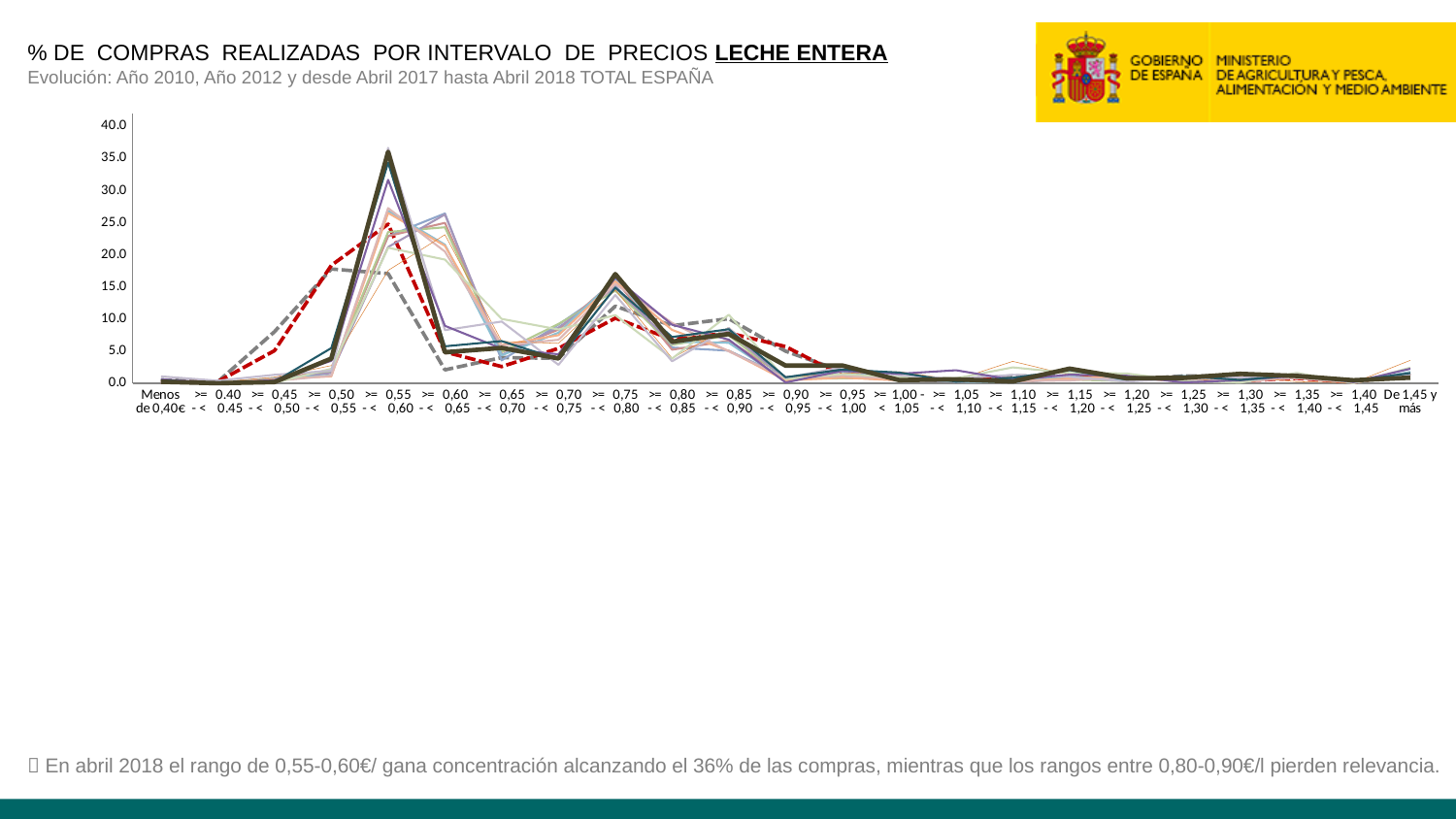
Is the value of the red dashed line for the interval >= 0,55 - < 0,60 greater or less than 30.0? less What is the highest tick value shown on the y axis of the chart? 40.0 What is the title of the chart on the slide? % DE COMPRAS REALIZADAS POR INTERVALO DE PRECIOS LECHE ENTERA How many price intervals are shown along the x axis of the chart? 23 Is the value of the thick dark line for the interval >= 0,55 - < 0,60 greater or less than 30.0? greater What kind of chart is shown on the slide? line chart Is the value of the thick dark line for the interval >= 1,00 - < 1,05 greater or less than 5.0? less Does the thick dark line rise or fall between the intervals >= 0,55 - < 0,60 and >= 0,60 - < 0,65? fall In which price interval does the thick dark line reach its highest value? >= 0,55 - < 0,60 For the thick dark line, which interval has the larger value: >= 0,55 - < 0,60 or >= 0,75 - < 0,80? >= 0,55 - < 0,60